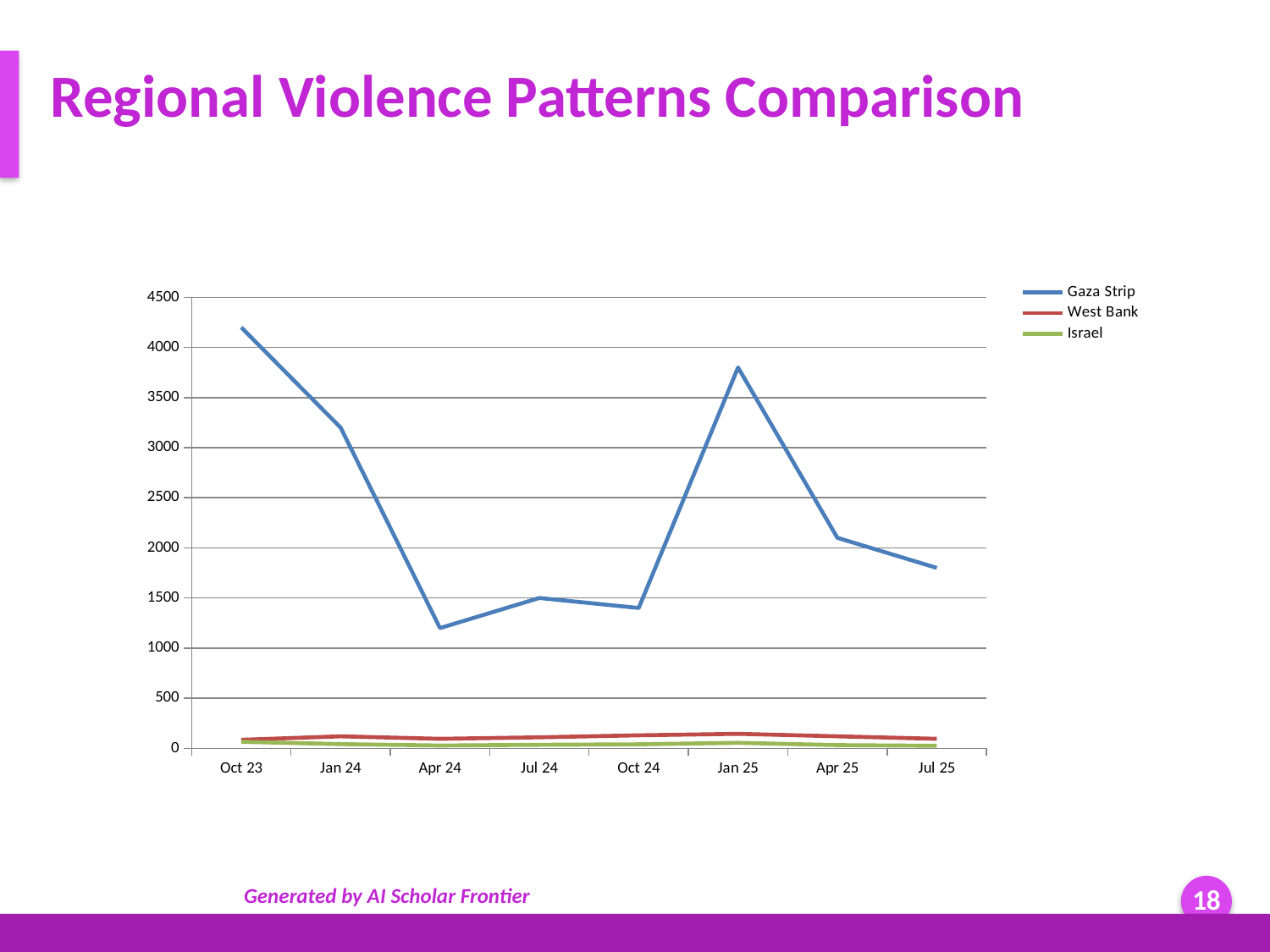
Does the Gaza Strip series rise or fall from Oct 23 to Apr 24? Fall Which series has the highest values across the chart? Gaza Strip How many series does the legend list? 3 Which series has the lowest values across the chart? Israel Is the Gaza Strip value for Jan 25 greater or less than 3500? greater How many time points are shown on the x axis? 8 What kind of chart is shown on the slide? Line chart Is the Gaza Strip value for Apr 24 greater or less than 1500? less At which time point does the Gaza Strip series reach its highest value? Oct 23 Is the Gaza Strip value for Oct 23 greater or less than 4000? greater For the Gaza Strip series, which is larger: the value for Jan 24 or the value for Jan 25? Jan 25 At which time point does the Gaza Strip series reach its lowest value? Apr 24